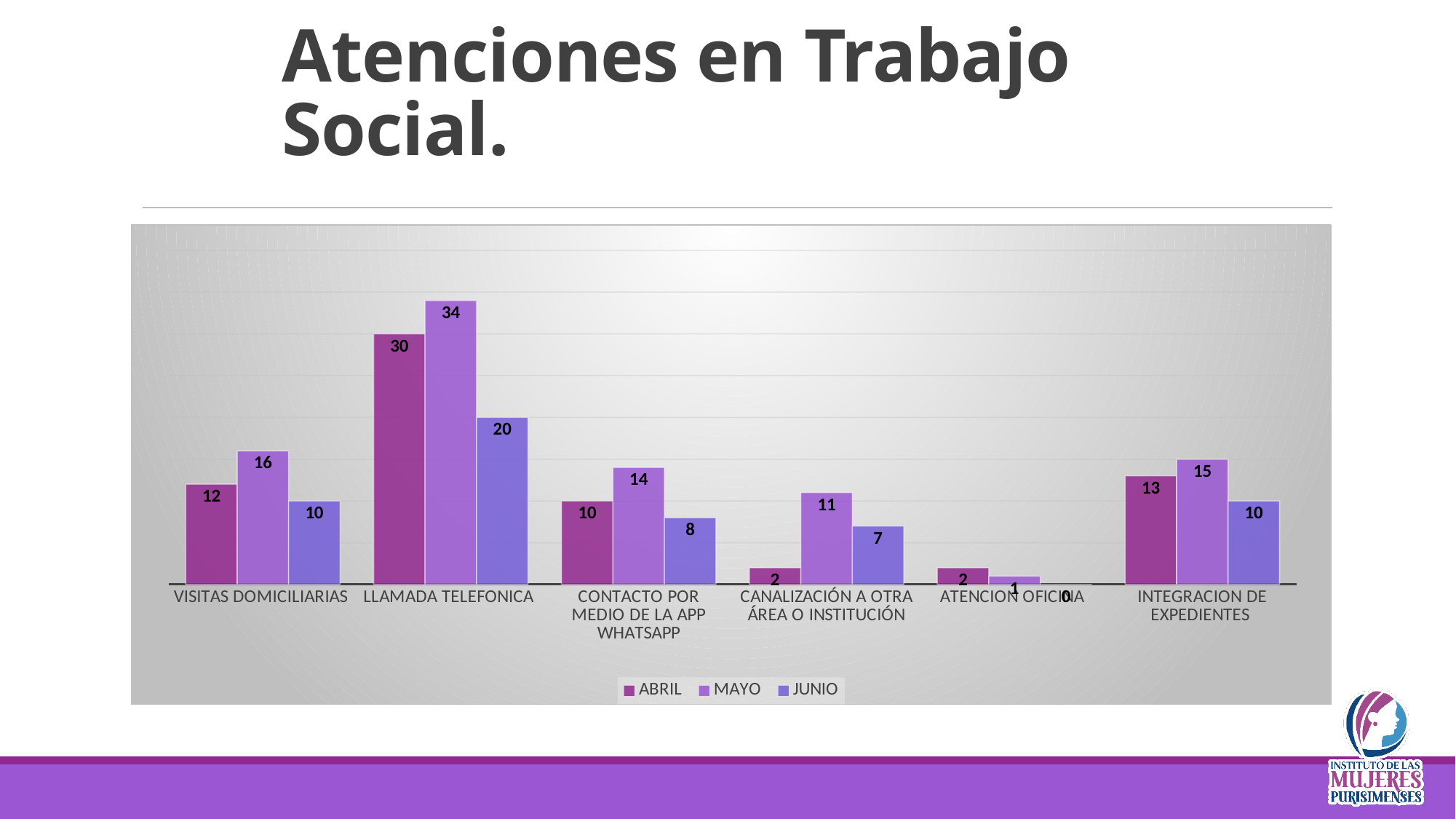
What is the value for MAYO in the LLAMADA TELEFONICA category? 34 Which category has the highest ABRIL value? LLAMADA TELEFONICA What is the total of the ABRIL, MAYO and JUNIO values for VISITAS DOMICILIARIAS? 38 How many series does the legend list? 3 What are the series names listed in the legend? ABRIL, MAYO, JUNIO What is the value for JUNIO in the VISITAS DOMICILIARIAS category? 10 What kind of chart is shown on the slide? Bar chart What is the difference between the MAYO and JUNIO values for LLAMADA TELEFONICA? 14 Which category has the lowest JUNIO value? ATENCION OFICINA How many categories are shown on the x axis? 6 What is the value for ABRIL in the INTEGRACION DE EXPEDIENTES category? 13 Which is larger: the MAYO value for CONTACTO POR MEDIO DE LA APP WHATSAPP or the MAYO value for CANALIZACIÓN A OTRA ÁREA O INSTITUCIÓN? CONTACTO POR MEDIO DE LA APP WHATSAPP